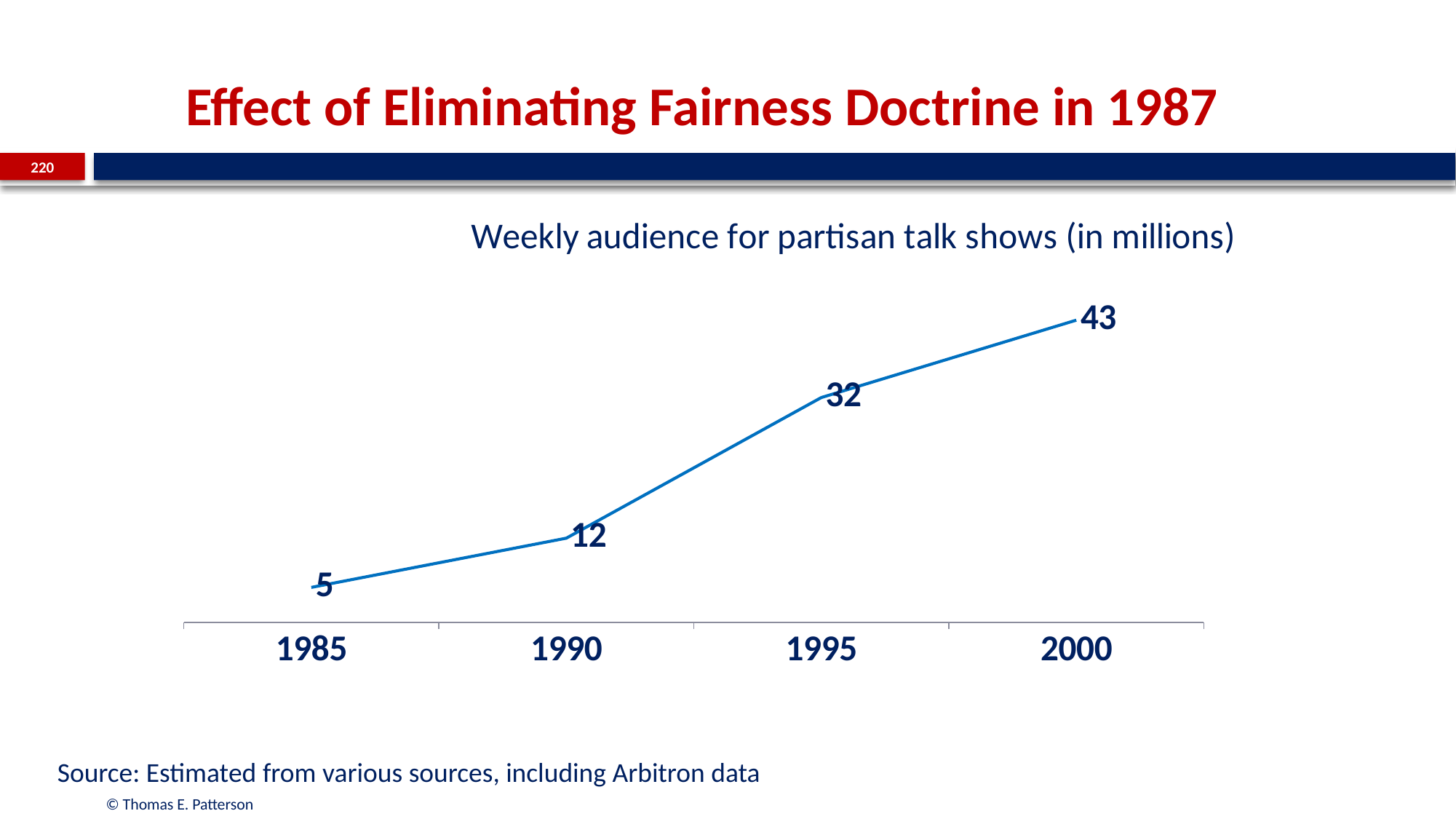
What is the weekly audience for partisan talk shows in 1990? 12 What kind of chart is shown on the slide? line chart Which year has a larger weekly audience, 1990 or 1995? 1995 Does the weekly audience rise or fall from 1985 to 2000? rise How many years are plotted on the chart? 4 What is the difference in weekly audience between 2000 and 1985? 38 What is the weekly audience for partisan talk shows in 1985? 5 What is the weekly audience for partisan talk shows in 1995? 32 Which year has the highest weekly audience? 2000 What is the weekly audience for partisan talk shows in 2000? 43 What is the difference in weekly audience between 1995 and 1990? 20 Which year has the lowest weekly audience? 1985